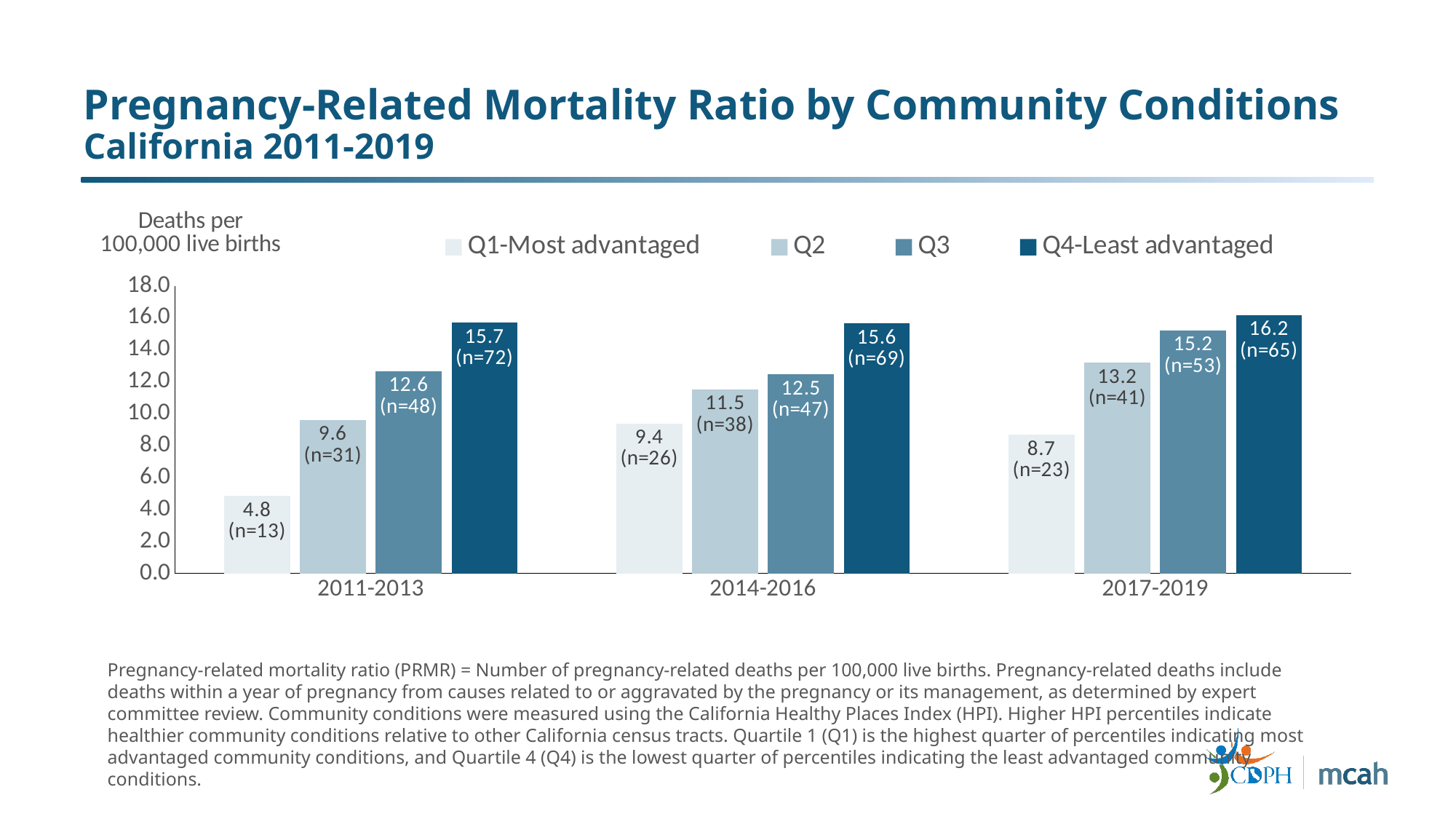
How many series does the legend list? 4 Which is larger: the Q3 value in 2011-2013 or the Q3 value in 2017-2019? Q3 in 2017-2019 What is the difference between the Q4-Least advantaged and Q1-Most advantaged values in 2014-2016? 6.2 What is the value for Q2 in 2014-2016? 11.5 What kind of chart is shown on the slide? Bar chart Is the value for Q2 in 2017-2019 greater or less than 12.0? greater Which quartile has the highest mortality ratio in 2017-2019? Q4-Least advantaged Does the Q1-Most advantaged value rise or fall from 2014-2016 to 2017-2019? Fall How many time periods are shown on the x axis? 3 What is the pregnancy-related mortality ratio for Q4-Least advantaged in 2011-2013? 15.7 What is the value for Q1-Most advantaged in 2017-2019? 8.7 Which quartile has the lowest mortality ratio in 2011-2013? Q1-Most advantaged